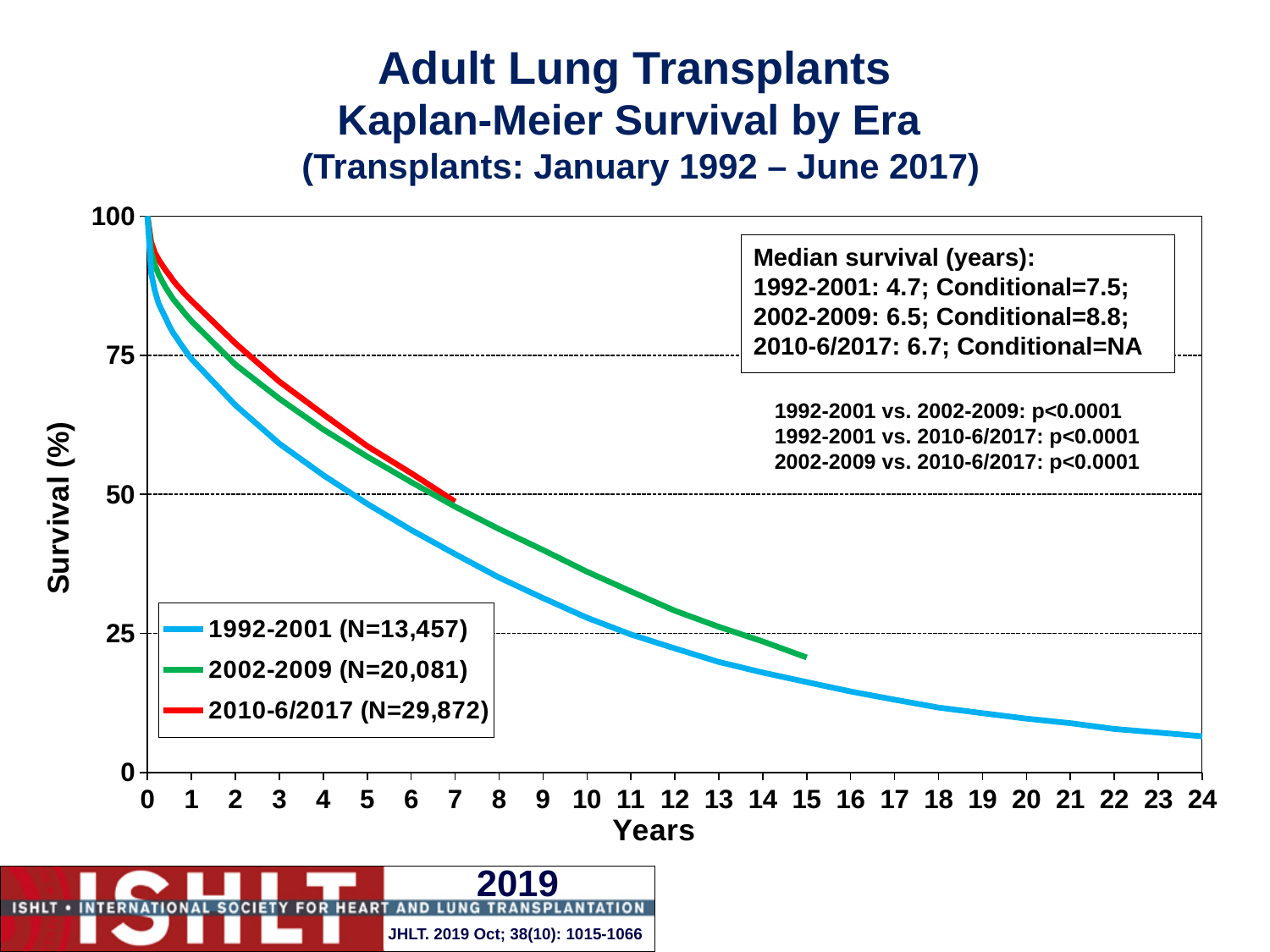
Which era has the lowest median survival? 1992-2001 What is the median survival in years for the 2002-2009 era? 6.5 What kind of chart is shown on the slide? Line chart At 10 years, which era has higher survival: 1992-2001 or 2002-2009? 2002-2009 Do the survival curves rise or fall as years increase? Fall What is the conditional median survival in years for the 1992-2001 era? 7.5 What is the difference in median survival (years) between the 2002-2009 era and the 1992-2001 era? 1.8 Which era has the highest median survival? 2010-6/2017 How many series (eras) does the legend list? 3 Is the survival for the 1992-2001 era at 10 years greater or less than 50%? less Is the survival for the 2002-2009 era at 15 years greater or less than 25%? less How many transplants (N) are in the 2010-6/2017 group according to the legend? 29,872